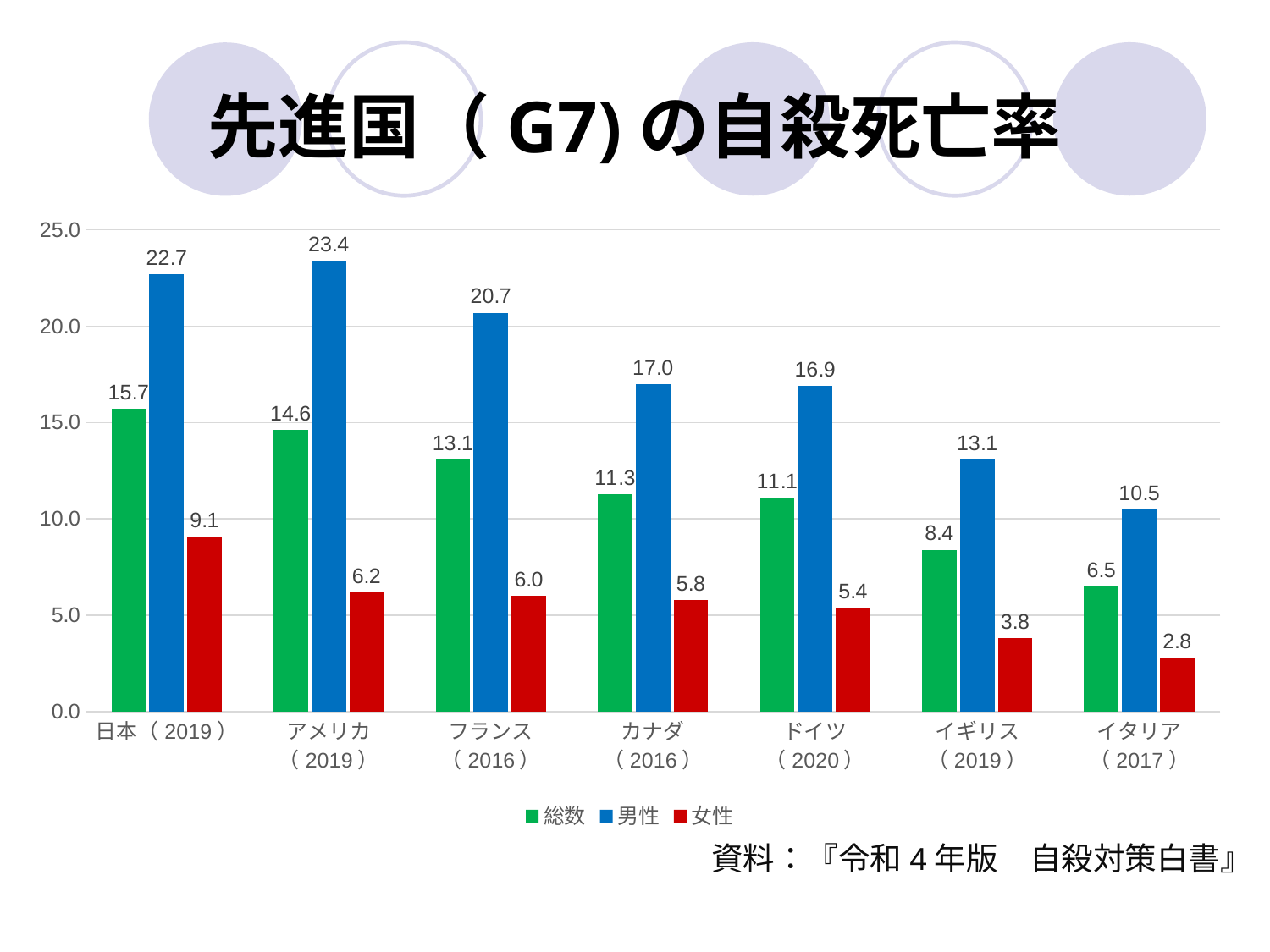
What is the difference between the 男性 and 女性 values for 日本 (2019)? 13.6 How many series does the legend list? 3 What colour represents the 女性 (female) series? red What is the 男性 (male) value for 日本 (2019)? 22.7 What is the 女性 (female) value for イタリア (2017)? 2.8 Which is larger, the 総数 value for カナダ (2016) or for ドイツ (2020)? カナダ (2016) Which country has the lowest 総数 (total) value? イタリア (2017) What kind of chart is shown on the slide? bar chart Is the 女性 value for 日本 (2019) greater or less than 10.0? less Which country has the highest 男性 (male) value? アメリカ (2019) How many countries are shown on the x axis? 7 What is the 総数 (total) value for フランス (2016)? 13.1